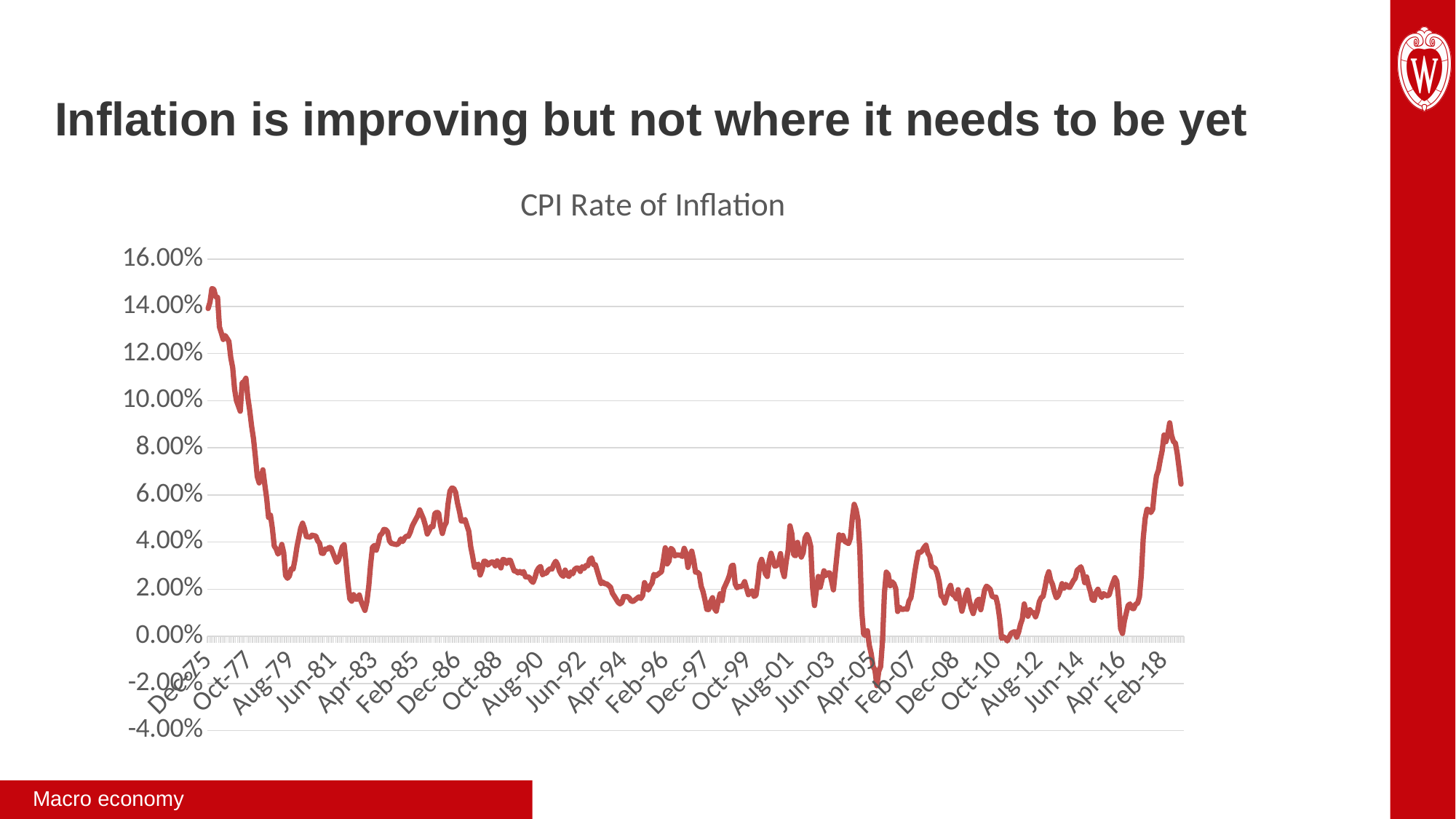
Which is larger, the value at Dec-75 or the value at Feb-18? Dec-75 Between Dec-75 and Aug-79, does the line rise or fall? fall Is the value at Oct-10 greater or less than 4.00%? less What kind of chart is shown on the slide? line chart Is the lowest point of the line above or below 0.00%? below Is the value at Feb-18 greater or less than 4.00%? greater How many date labels are shown on the x axis? 24 Near which x-axis label does the line reach its highest value? Dec-75 What is the title of the chart? CPI Rate of Inflation What colour is the line in the chart? red